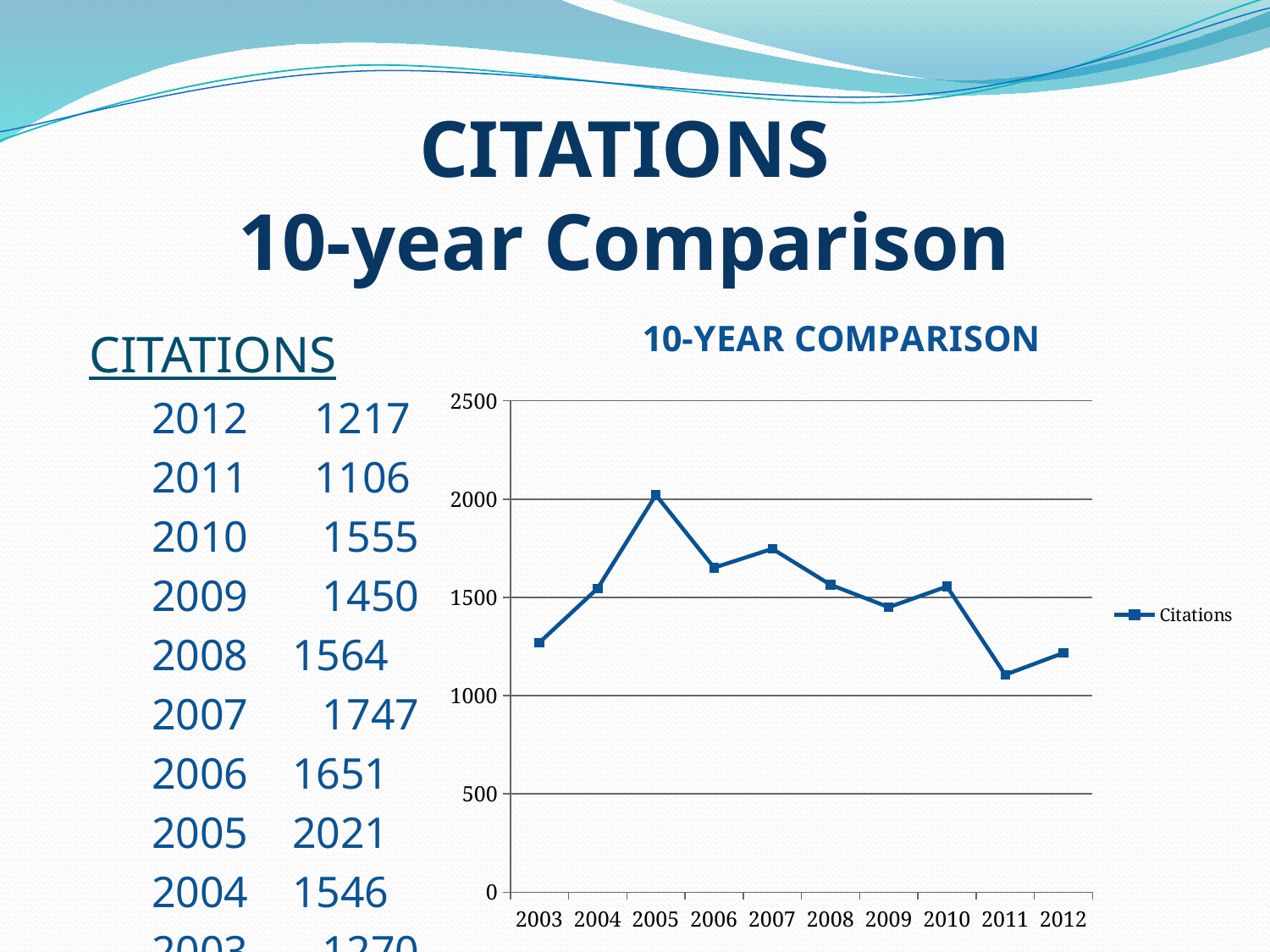
How many series does the legend list? 1 How many years are plotted on the chart? 10 Which year has the lowest number of citations? 2011 What type of chart is shown on the slide? line chart Do citations rise or fall from 2010 to 2011? fall What is the difference in citations between 2005 and 2011? 915 What is the number of citations for 2005? 2021 Which year has more citations, 2007 or 2010? 2007 What is the number of citations for 2011? 1106 Is the value for 2003 greater or less than 1500? less What is the number of citations for 2008? 1564 Which year has the highest number of citations? 2005